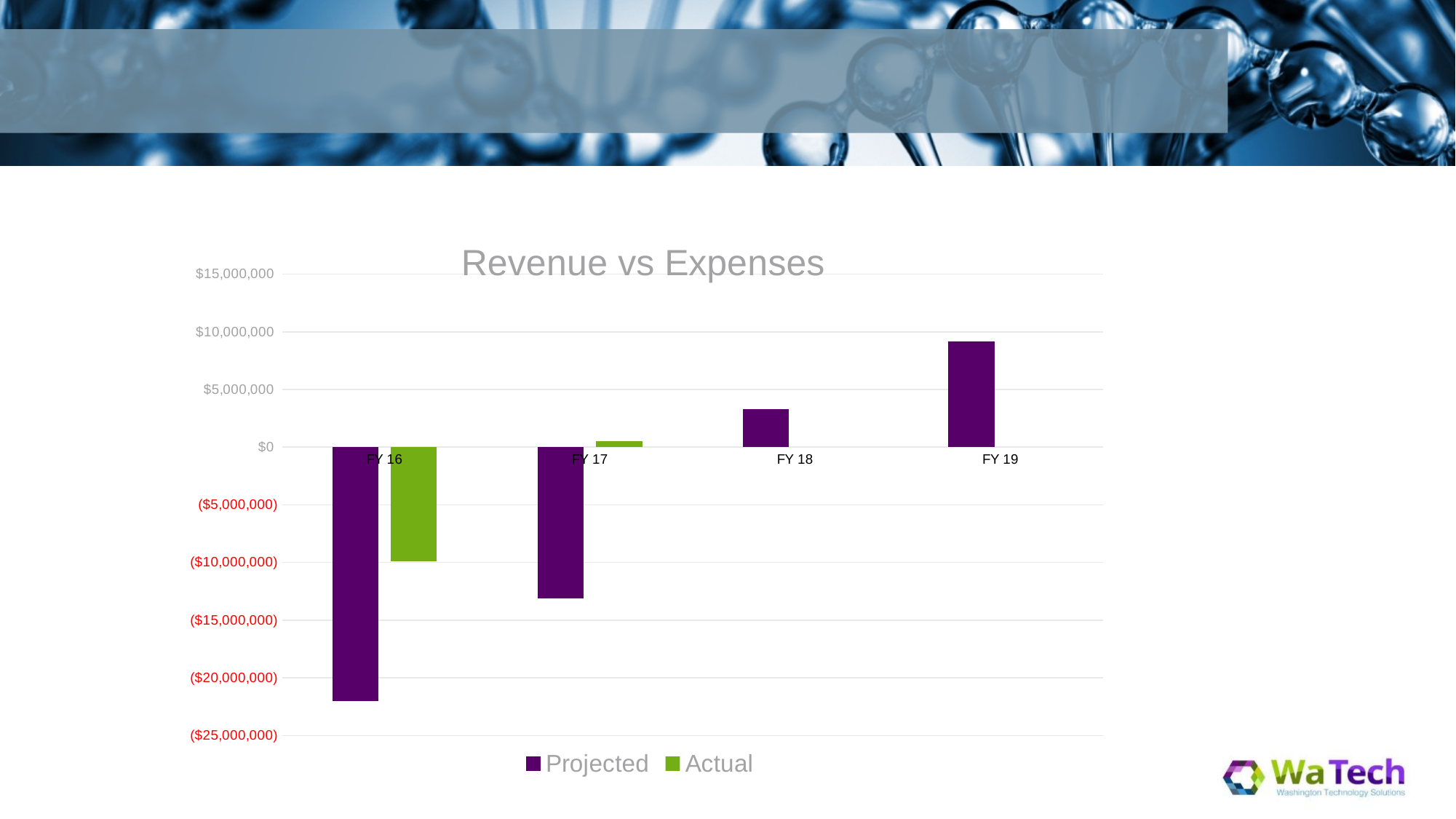
Which fiscal year has the highest Projected value? FY 19 Is the Projected value for FY 16 greater or less than ($20,000,000)? less Which is larger, the Projected value for FY 18 or for FY 19? FY 19 Is the Projected value for FY 17 greater or less than ($10,000,000)? less What kind of chart is shown on the slide? bar chart Is the Projected value for FY 19 greater or less than $5,000,000? greater Do the Projected values rise or fall from FY 16 to FY 19? rise How many fiscal year categories are shown on the x axis? 4 What is the title of the chart? Revenue vs Expenses Which fiscal year has the lowest Projected value? FY 16 How many series does the legend list? 2